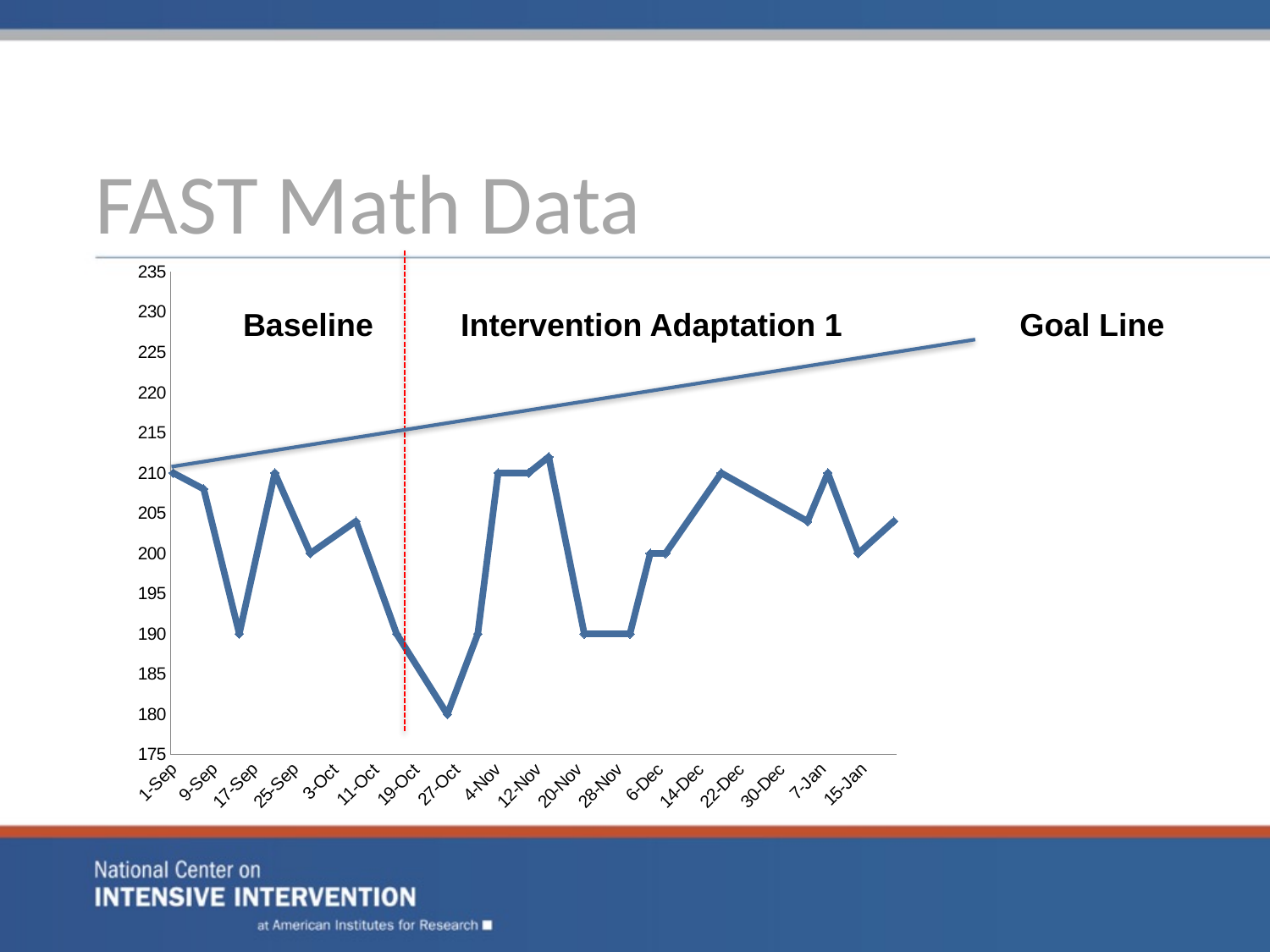
What is the highest value shown on the y axis? 235 Is the value for 1-Sep greater or less than 205? greater What kind of chart is shown on the slide? line chart Does the Goal Line rise or fall from left to right? rises What is the title of the slide's chart? FAST Math Data How many date labels are shown on the x axis? 18 What are the two phases labelled on the chart, separated by the dashed red line? Baseline and Intervention Adaptation 1 Is the lowest point on the data line greater or less than 185? less What is the value of the data line at 1-Sep? 210 Is the value for 17-Sep greater or less than 195? less What is the lowest value reached by the data line? 180